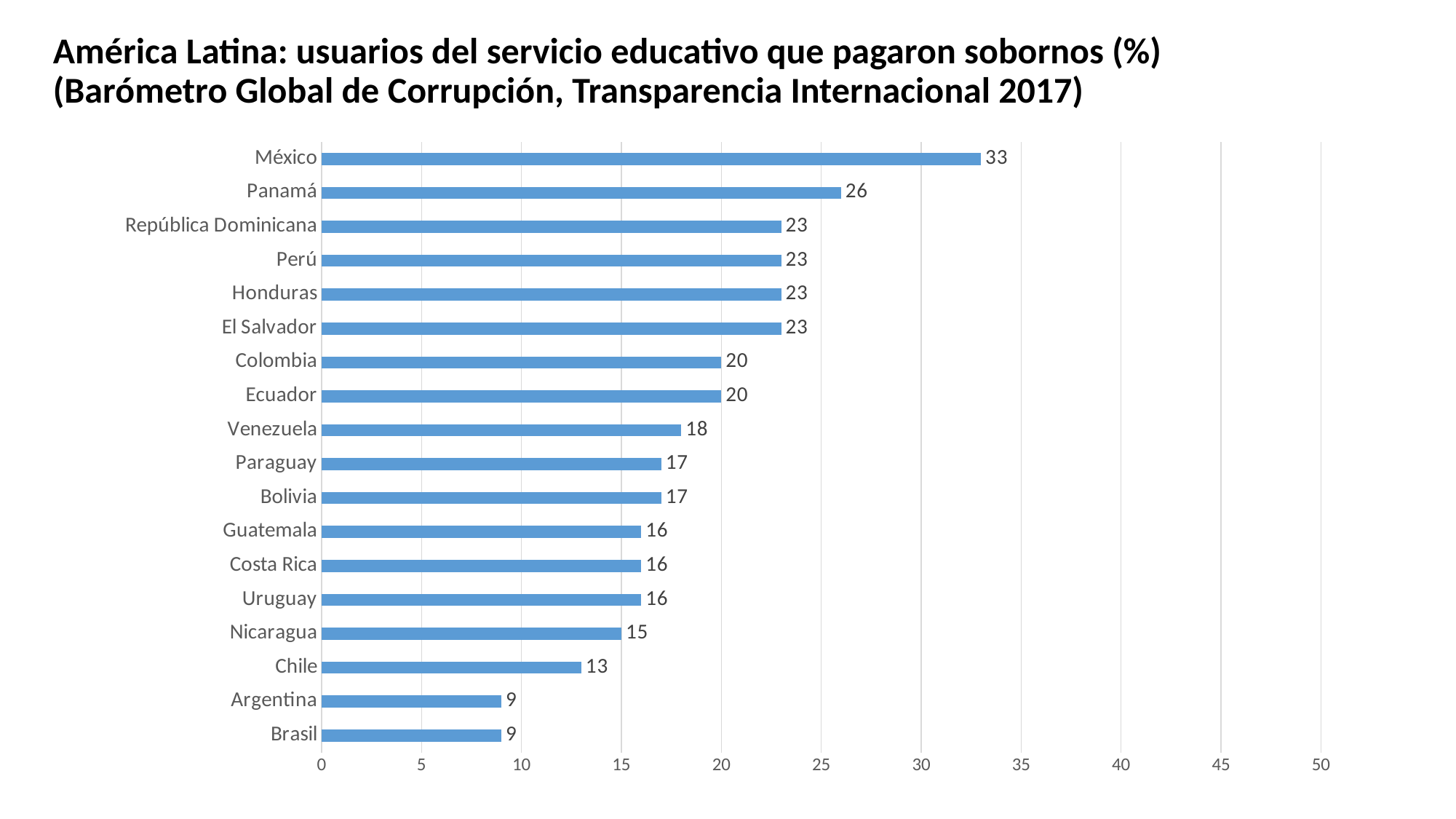
Is the value for República Dominicana greater or less than 20? greater What is the value for Chile? 13 What is the highest value shown on the horizontal axis? 50 How many countries are shown in the chart? 18 Which country has the highest value? México Which is larger, the value for Panamá or the value for Perú? Panamá What is the difference between the values for México and Panamá? 7 How many countries have a value of 23? 4 What is the value for Venezuela? 18 What is the value for México? 33 What kind of chart is shown on the slide? bar chart What is the difference between the values for Colombia and Nicaragua? 5